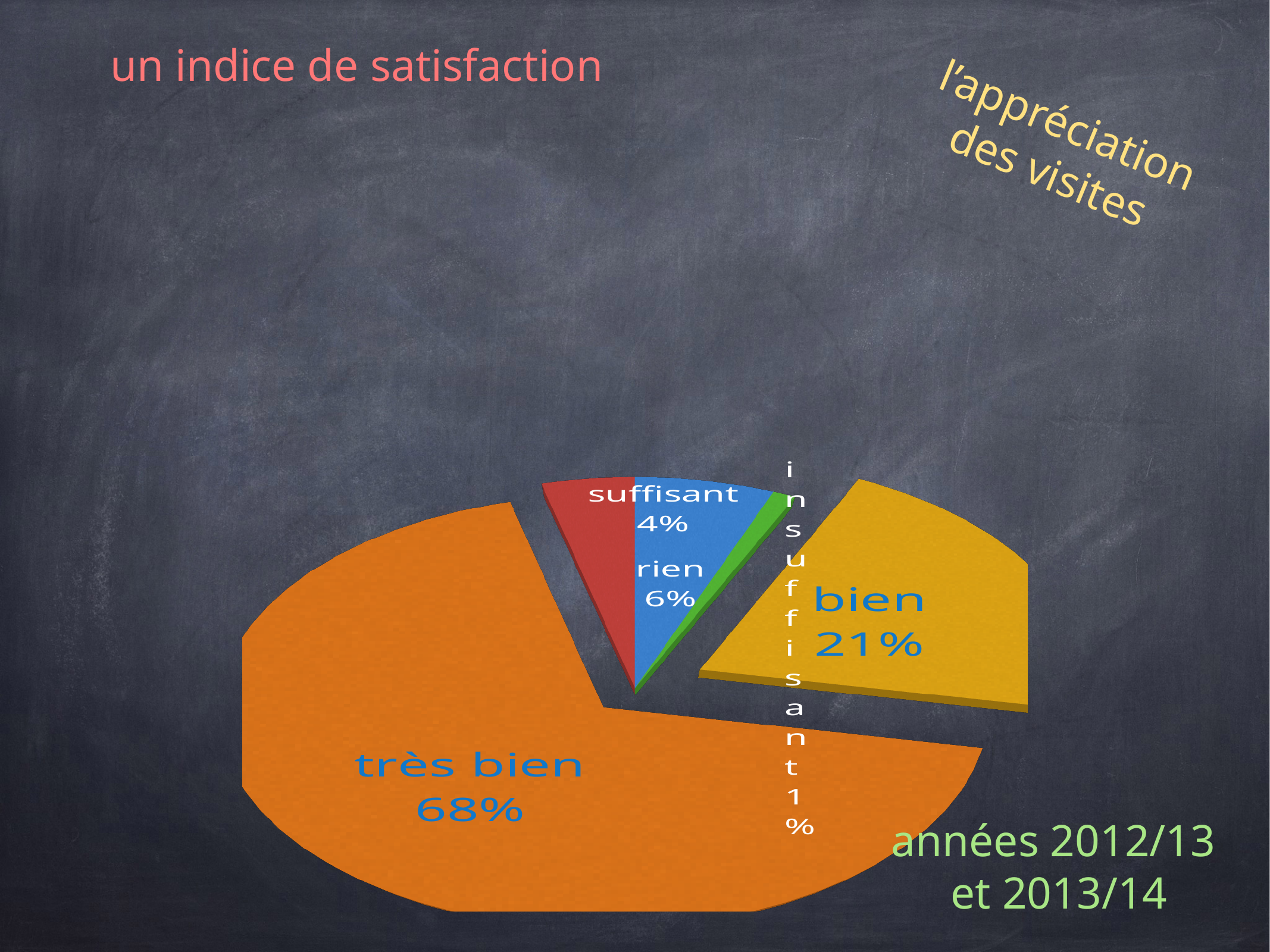
Which category has the smallest share of the pie? insuffisant What percentage is shown for "suffisant"? 4% What kind of chart is shown on the slide? pie chart What percentage is shown for "insuffisant"? 1% What percentage is shown for "rien"? 6% What is the difference in percentage points between "très bien" and "bien"? 47 What percentage of the pie is labelled "bien"? 21% Which is larger, the share for "rien" or the share for "suffisant"? rien What colour is the "très bien" slice? orange How many categories are shown in the pie chart? 5 What percentage of the pie is labelled "très bien"? 68% Which category has the largest share of the pie? très bien